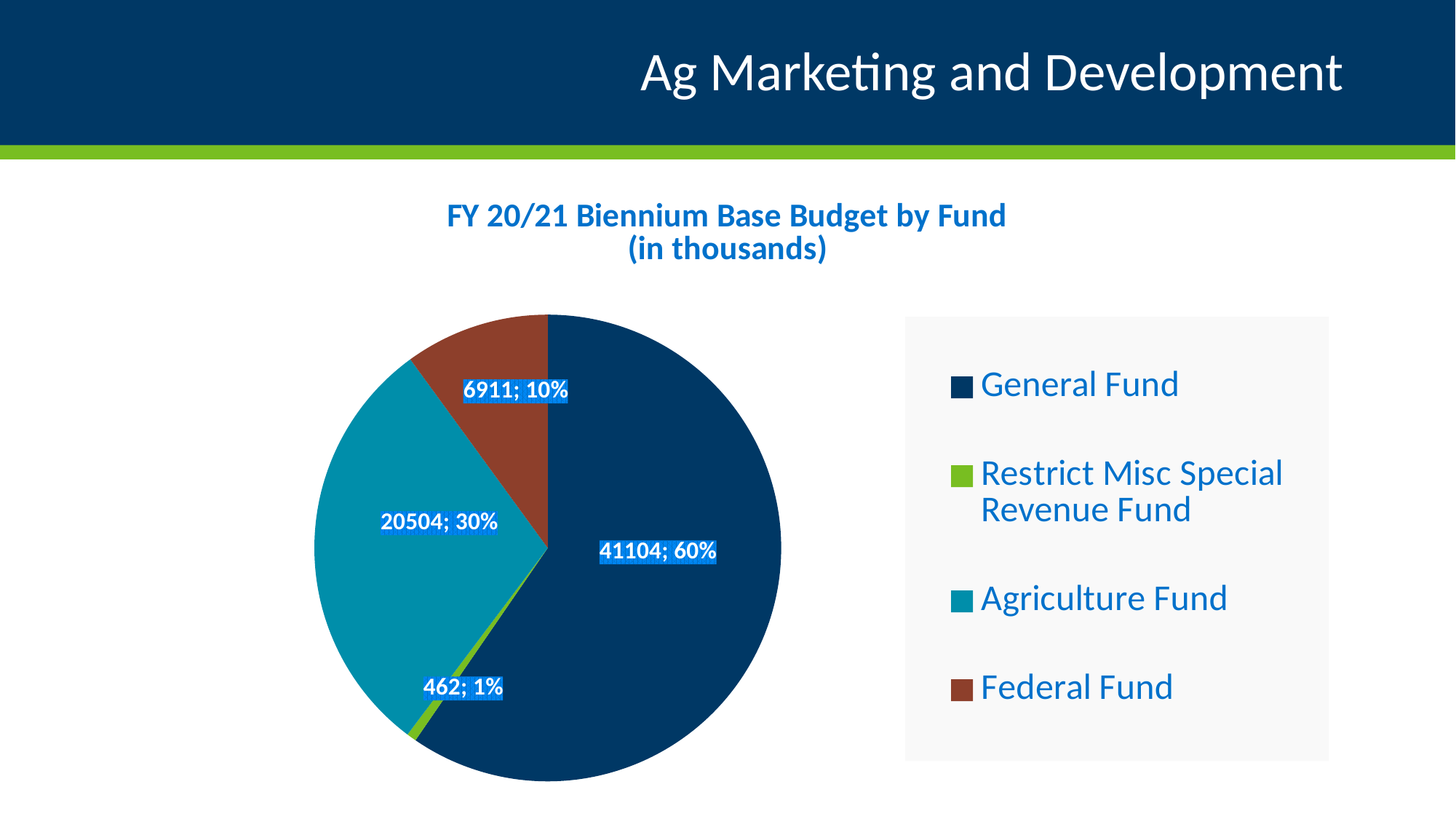
What share of the pie does the Federal Fund represent? 10% What is the value for the Federal Fund? 6911 Which fund has the smallest slice of the pie? Restrict Misc Special Revenue Fund What is the value for the Restrict Misc Special Revenue Fund? 462 What is the value for the General Fund? 41104 Which fund has the largest slice of the pie? General Fund What is the title of the chart? FY 20/21 Biennium Base Budget by Fund (in thousands) What is the difference between the General Fund value and the Agriculture Fund value? 20600 What is the value for the Agriculture Fund? 20504 What type of chart is shown on the slide? pie chart What share of the pie does the Agriculture Fund represent? 30% How many funds are shown in the legend? 4